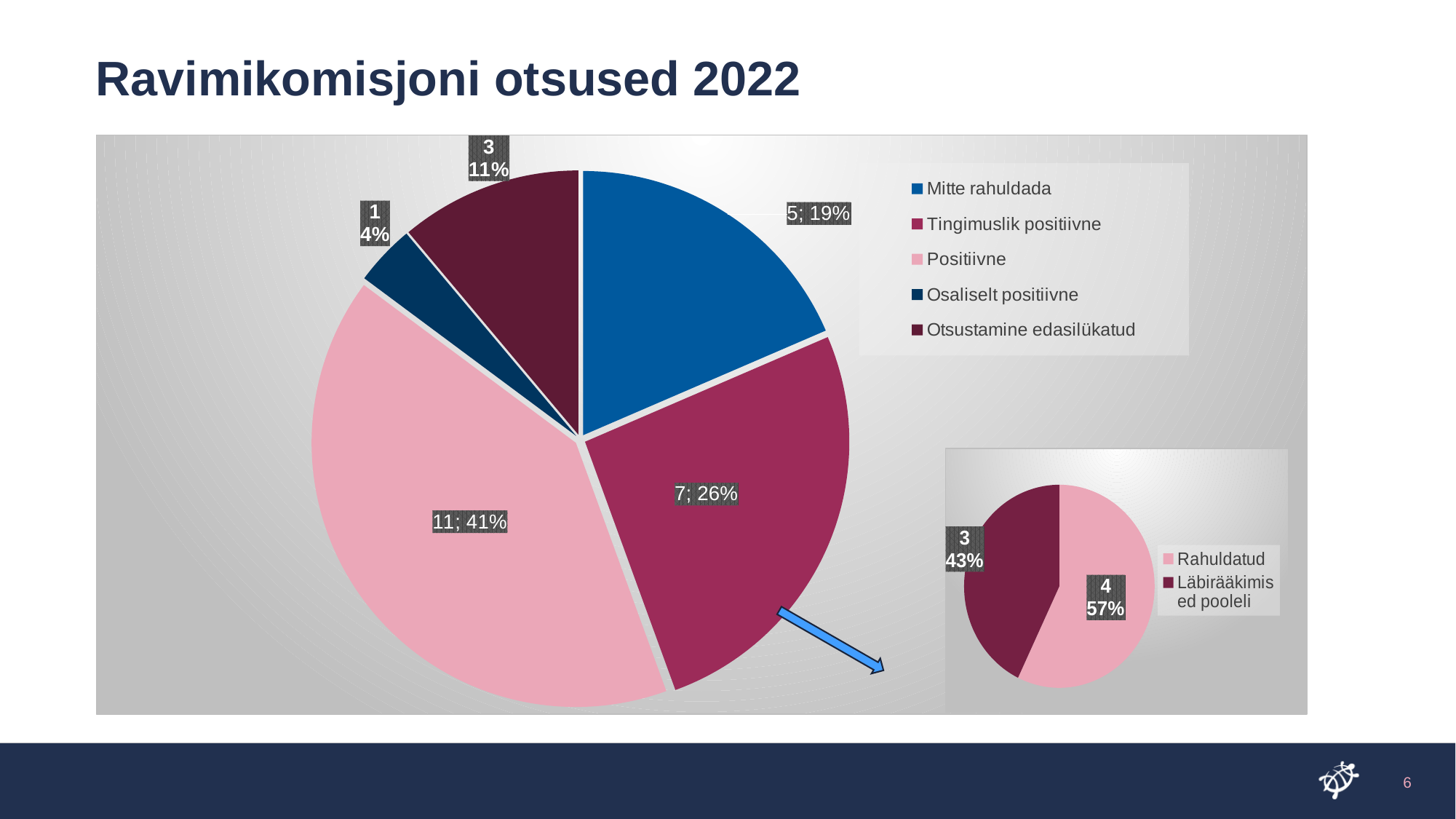
In the large pie chart on the left, what is the count shown for Mitte rahuldada? 5 In the small pie chart on the lower right, what is the count shown for Läbirääkimised pooleli? 3 In the large pie chart on the left, which category has the largest slice? Positiivne In the large pie chart on the left, how many decisions are labelled Positiivne? 11 In the large pie chart on the left, what is the difference between the counts for Positiivne and Tingimuslik positiivne? 4 In the large pie chart on the left, which is larger: Mitte rahuldada or Otsustamine edasilükatud? Mitte rahuldada In the large pie chart on the left, what percentage share does the Tingimuslik positiivne slice show? 26% In the small pie chart on the lower right, which category has the larger slice? Rahuldatud In the small pie chart on the lower right, what percentage share is shown for Rahuldatud? 57% How many categories does the legend of the large pie chart on the left list? 5 In the large pie chart on the left, which category has the smallest slice? Osaliselt positiivne What type of chart is the large chart on the left? Pie chart